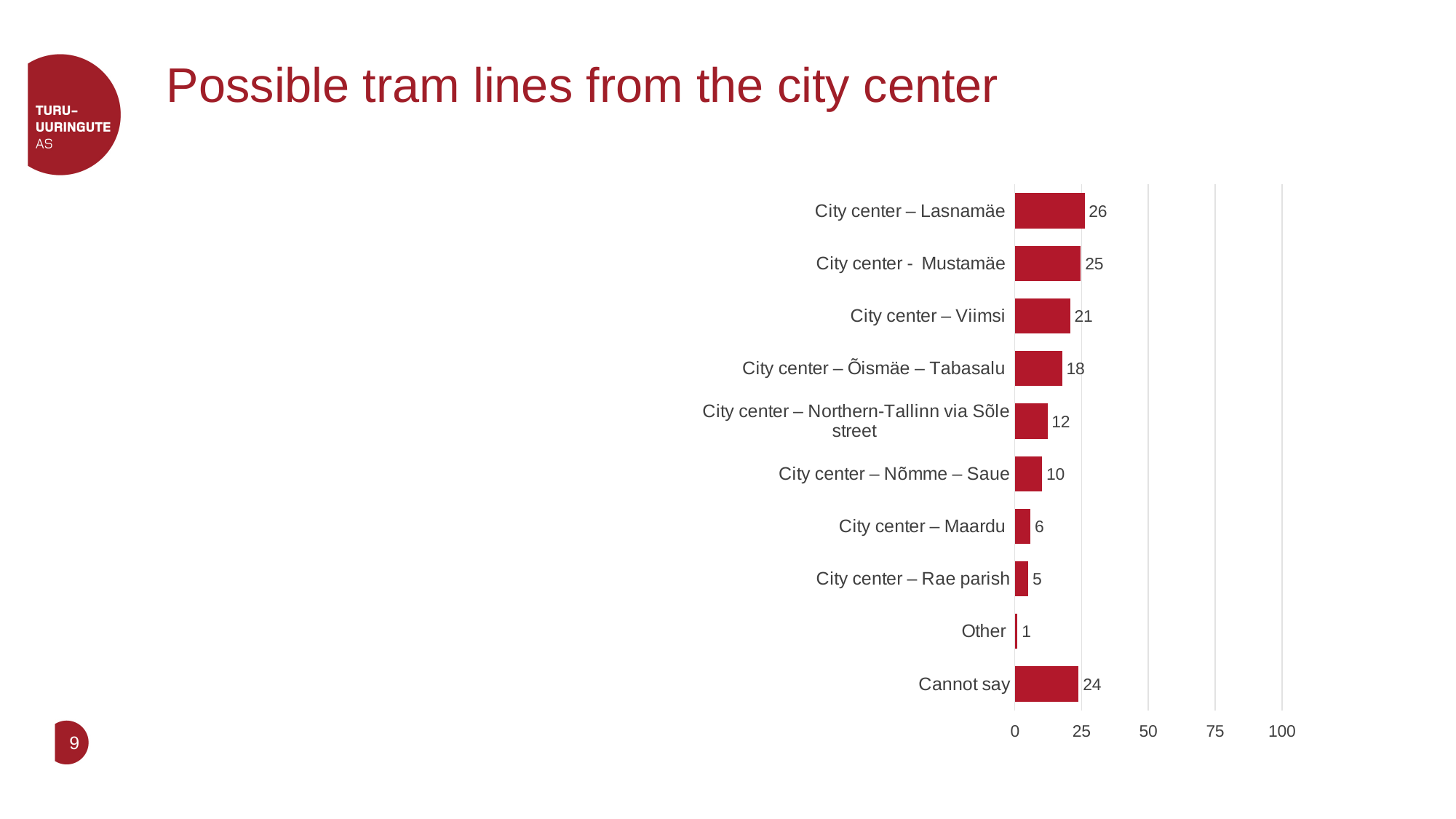
Which is larger, the value for City center – Õismäe – Tabasalu or the value for City center – Nõmme – Saue? City center – Õismäe – Tabasalu What is the value for City center – Lasnamäe? 26 What is the highest value shown on the x axis? 100 What kind of chart is shown on the slide? bar chart How many categories are shown in the chart? 10 What is the difference between the values for City center – Viimsi and City center – Maardu? 15 Is the value for City center - Mustamäe greater or less than 50? less What is the value for Cannot say? 24 What is the title of the slide? Possible tram lines from the city center Which category has the highest value? City center – Lasnamäe What is the value for City center – Northern-Tallinn via Sõle street? 12 Which category has the lowest value? Other